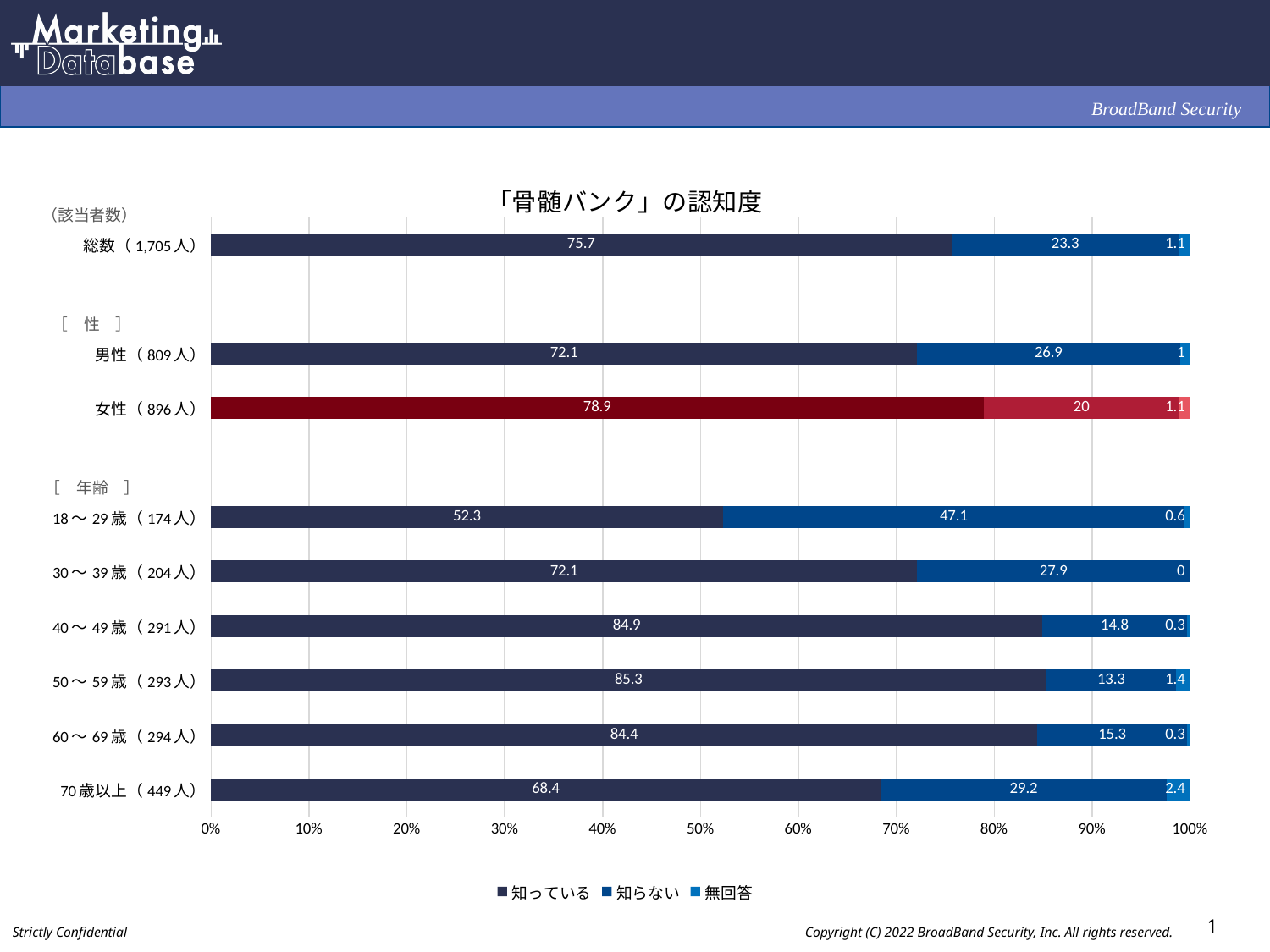
What is the 知っている value for 総数 (1,705人)? 75.7 Which has a larger 知らない value, 30～39歳 (204人) or 40～49歳 (291人)? 30～39歳 (204人) How many series does the legend list? 3 How many categories (bars) are plotted in the chart? 9 Which age group has the highest 知っている value? 50～59歳 (293人) What is the 知らない value for 18～29歳 (174人)? 47.1 Which category has the lowest 知っている value? 18～29歳 (174人) What is the 無回答 value for 70歳以上 (449人)? 2.4 What is the title of the chart? 「骨髄バンク」の認知度 What is the difference between the 知っている values for 女性 (896人) and 男性 (809人)? 6.8 What kind of chart is shown on the slide? Stacked bar chart What is the total of the stacked bar for 60～69歳 (294人)? 100